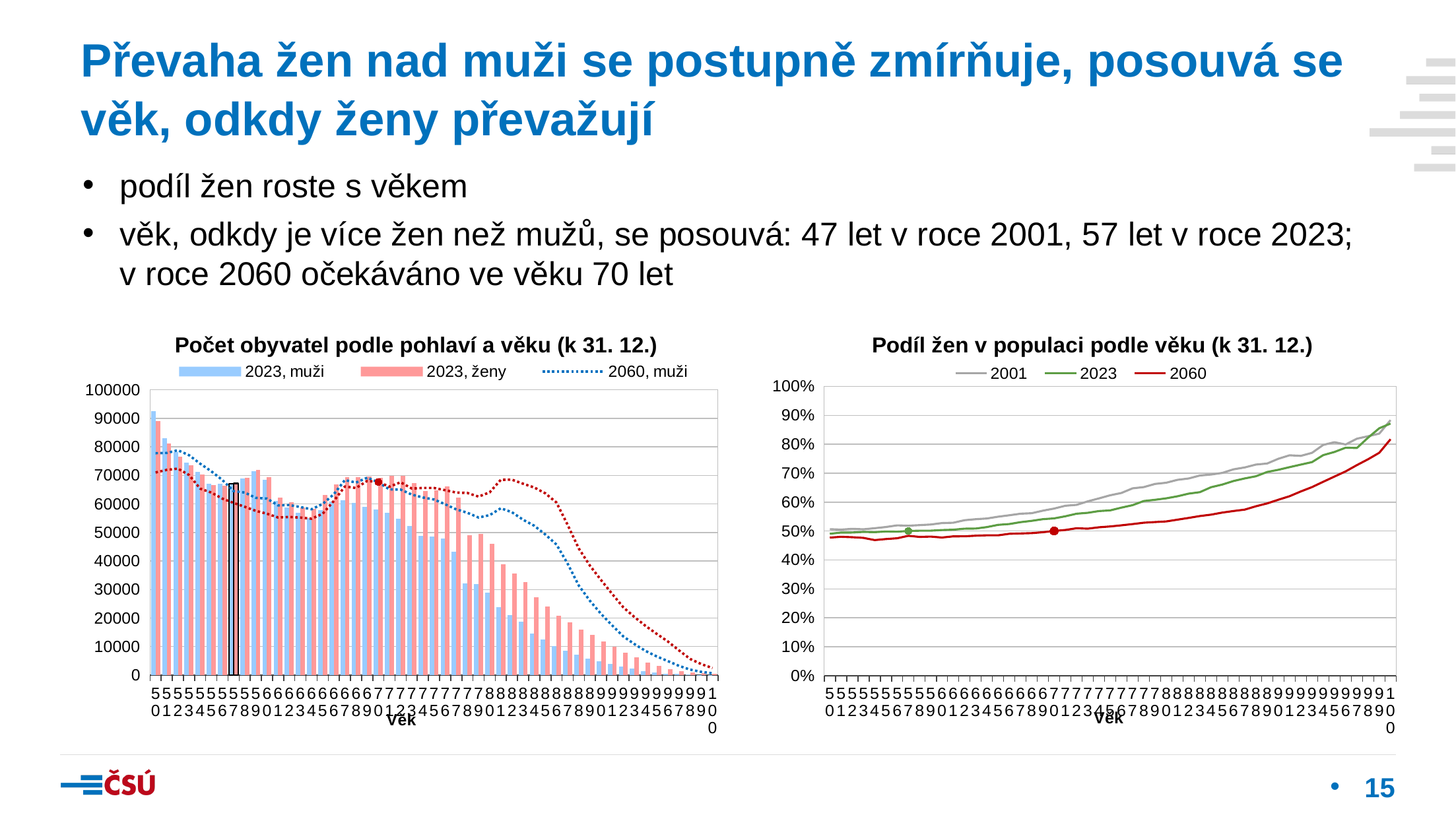
What kind of chart is the left chart, 'Počet obyvatel podle pohlaví a věku (k 31. 12.)'? combination bar and line chart In the right chart, does the 2023 line rise or fall as age increases from 50 to 100? rise What is the title of the left chart? Počet obyvatel podle pohlaví a věku (k 31. 12.) In the right chart, is the 2001 value at age 100 greater or less than 80%? greater In the right chart, which series is higher at age 80, 2001 or 2060? 2001 What kind of chart is the right chart, 'Podíl žen v populaci podle věku (k 31. 12.)'? line chart In the left chart, which is larger at age 85, '2023, muži' or '2023, ženy'? 2023, ženy How many series does the legend of the left chart list? 3 How many series does the legend of the right chart list? 3 In the left chart, is the '2023, ženy' value at age 100 greater or less than 10000? less In the right chart, what colour is the 2060 line? red